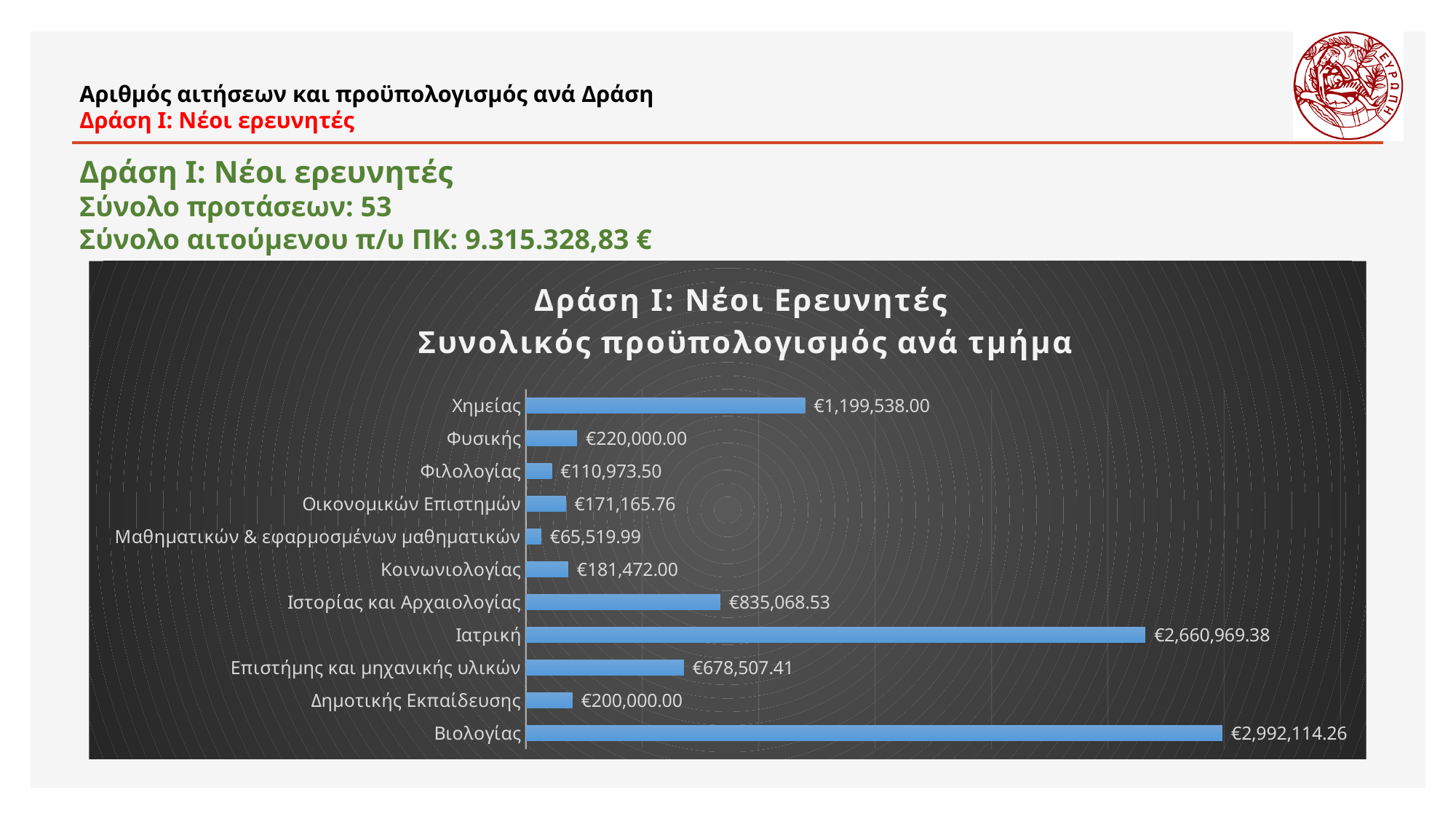
What is the title of the chart? Δράση Ι: Νέοι Ερευνητές Συνολικός προϋπολογισμός ανά τμήμα What is the difference between the values for Φυσικής and Δημοτικής Εκπαίδευσης? €20,000.00 What is the value for Ιατρική? €2,660,969.38 What is the difference between the values for Βιολογίας and Ιατρική? €331,144.88 What is the value for Χημείας? €1,199,538.00 How many categories are shown in the chart? 11 What is the value for Επιστήμης και μηχανικής υλικών? €678,507.41 Which category has the lowest value? Μαθηματικών & εφαρμοσμένων μαθηματικών What is the value for Μαθηματικών & εφαρμοσμένων μαθηματικών? €65,519.99 Which category has the highest value? Βιολογίας Which is larger, the value for Κοινωνιολογίας or the value for Οικονομικών Επιστημών? Κοινωνιολογίας What kind of chart is shown on the slide? Bar chart